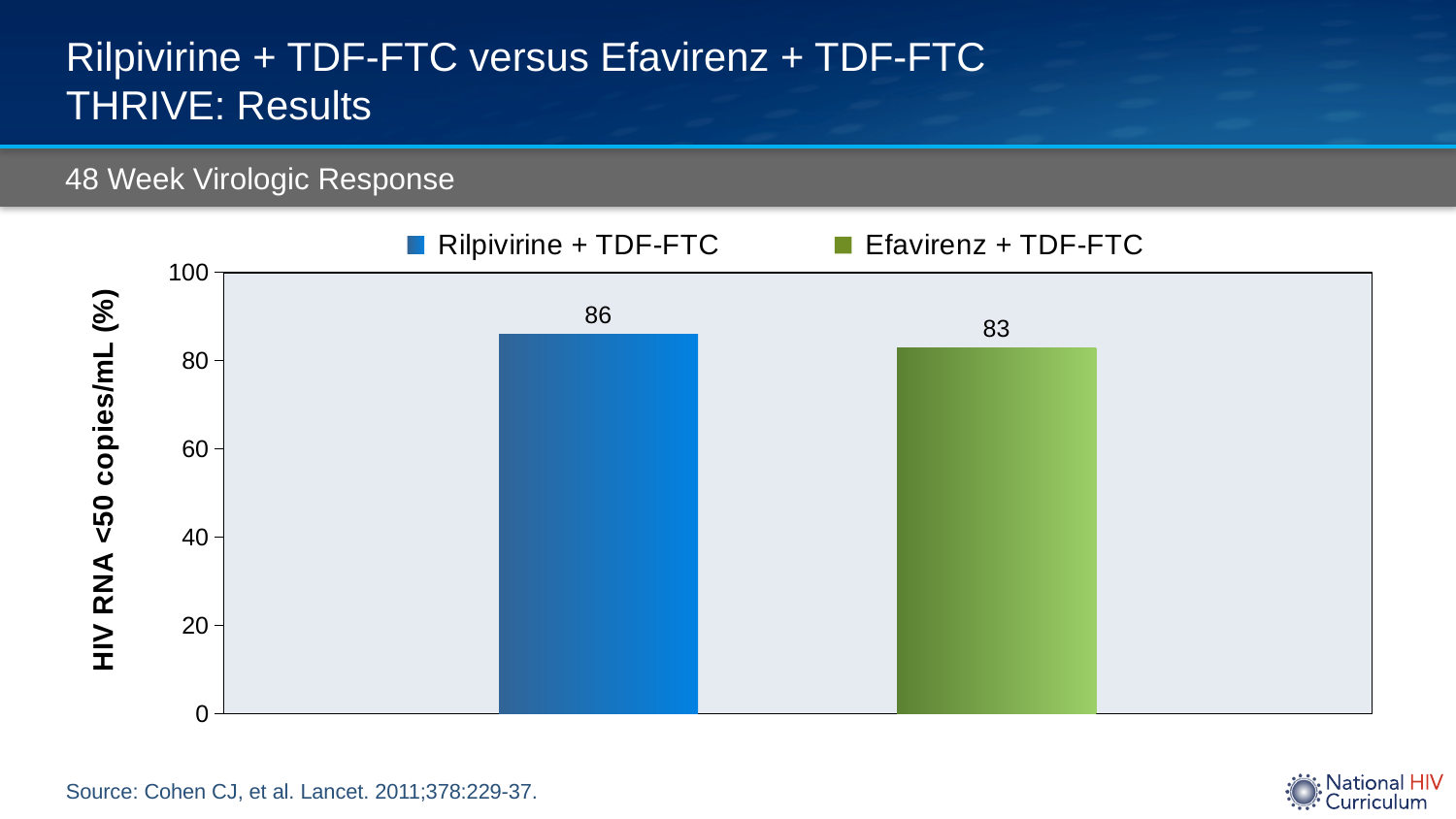
What kind of chart is shown? Bar chart What colour is the bar for Efavirenz + TDF-FTC? Green How many series does the legend list? 2 Is the value for Efavirenz + TDF-FTC greater or less than 80? greater Is the value for Rilpivirine + TDF-FTC greater or less than 100? less How many bars are plotted in the chart? 2 What is the value for Rilpivirine + TDF-FTC? 86 What is the difference between the Rilpivirine + TDF-FTC and Efavirenz + TDF-FTC values? 3 Which series has the higher value, Rilpivirine + TDF-FTC or Efavirenz + TDF-FTC? Rilpivirine + TDF-FTC What is the value for Efavirenz + TDF-FTC? 83 Which series has the lowest value? Efavirenz + TDF-FTC What is the label of the y axis? HIV RNA <50 copies/mL (%)